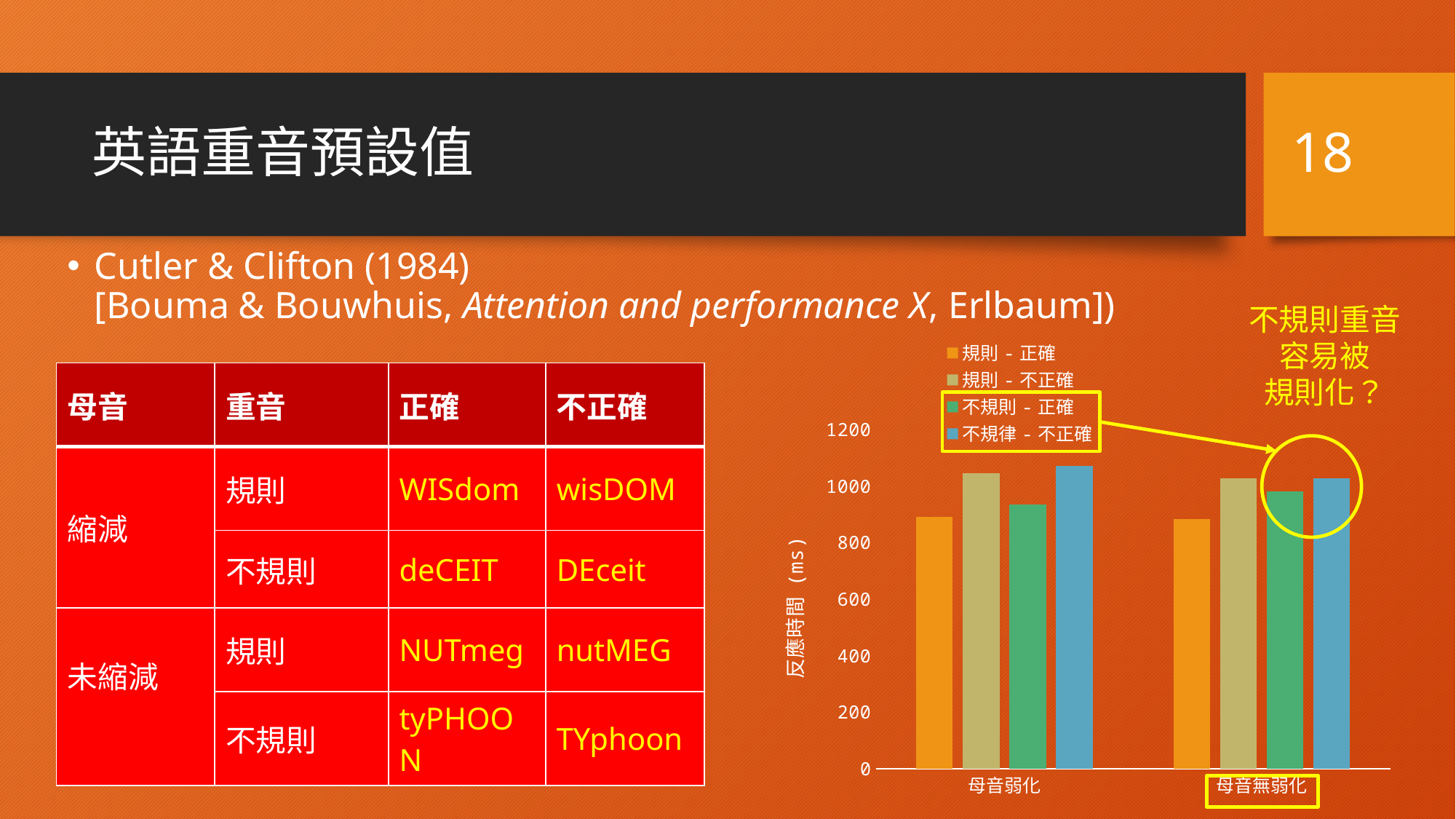
Is the value for 規則 - 正確 in the 母音無弱化 category greater or less than 1000? less Is the value for 規則 - 不正確 in the 母音弱化 category greater or less than 1000? greater What is the label of the chart's y axis? 反應時間（ms） Which series has the lowest value in the 母音弱化 category? 規則 - 正確 How many categories are shown on the x axis of the chart? 2 What kind of chart is shown on the slide? bar chart In the 母音無弱化 category, which is larger: 規則 - 正確 or 不規則 - 正確? 不規則 - 正確 Is the value for 不規律 - 不正確 in the 母音弱化 category greater or less than 1000? greater How many series does the chart's legend list? 4 Which series is shown in orange in the chart's legend? 規則 - 正確 Which series has the lowest value in the 母音無弱化 category? 規則 - 正確